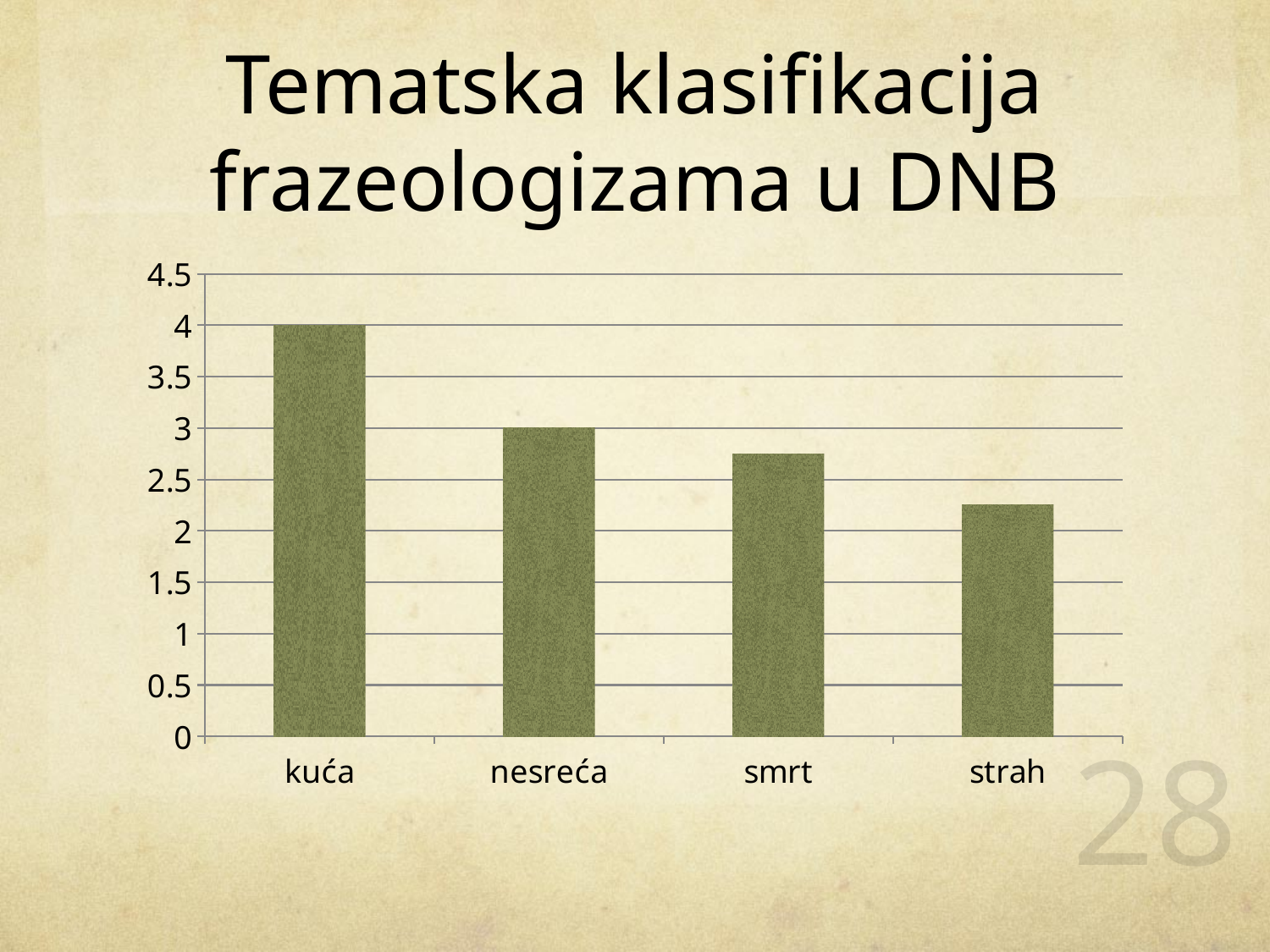
What is the value for kuća in the chart? 4 Which has the larger value, smrt or strah? smrt Is the value for strah greater or less than 2.5? less What kind of chart is shown on the slide? bar chart What is the value for nesreća in the chart? 3 How many categories are shown on the x axis of the chart? 4 What is the difference between the values for kuća and nesreća? 1 Which category has the lowest bar in the chart? strah Which category has the highest bar in the chart? kuća Do the bar values rise or fall from left to right along the x axis? fall What is the title of the slide containing the chart? Tematska klasifikacija frazeologizama u DNB Is the value for smrt greater or less than 2.5? greater